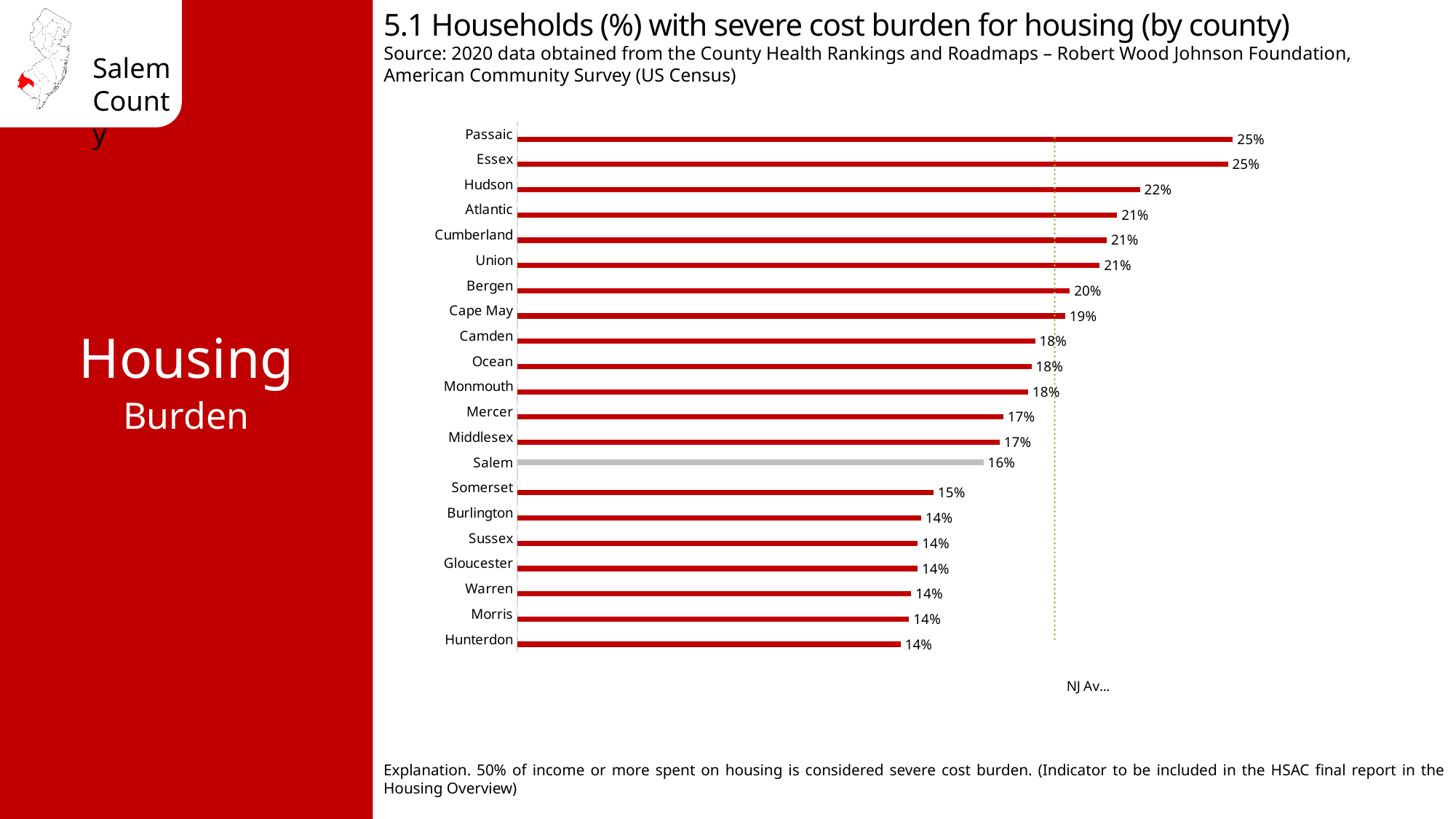
What is the value for Somerset in the chart? 15% What is the value for Cape May in the chart? 19% What kind of chart is shown on the slide? Bar chart What is the difference between the values for Hudson and Salem? 6% What is the difference between the values for Passaic and Hunterdon? 11% Which county's bar is shown in grey rather than red? Salem What is the value for Bergen in the chart? 20% What is the value for Salem in the chart? 16% Which has a larger value, Salem or Somerset? Salem Which has a larger value, Atlantic or Mercer? Atlantic How many counties are shown in the chart? 21 What is the value for Hudson in the chart? 22%